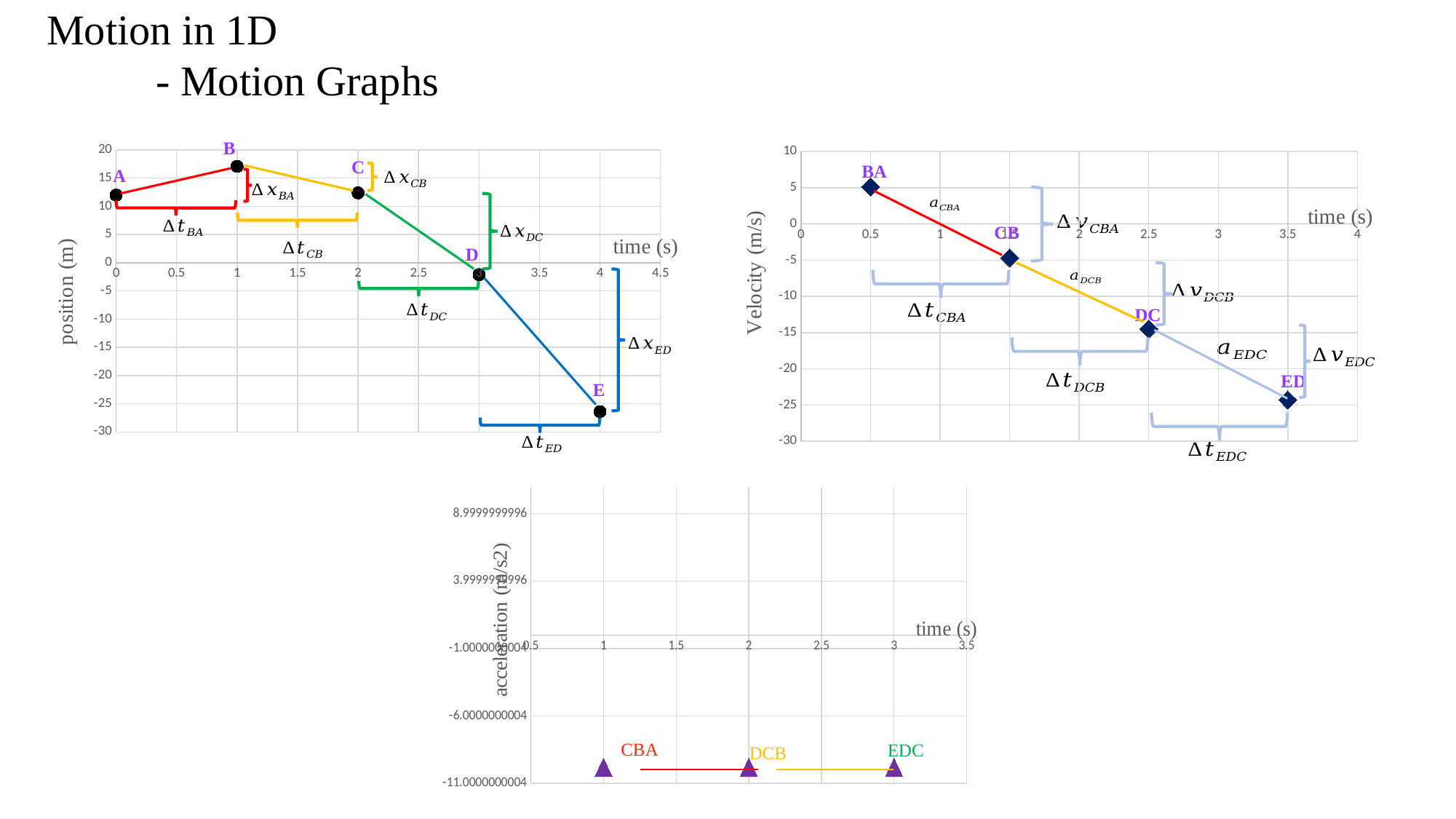
In the position vs time chart, how many labelled data points are plotted? 5 In the position vs time chart, at what time does point D occur? 3 In the position vs time chart, which has the larger position, point B or point C? B What kind of chart is the position vs time chart at the top left? line chart In the position vs time chart, which point has the lowest position? E In the velocity vs time chart, is the velocity at point ED greater or less than -20? less In the velocity vs time chart, do the velocity values rise or fall as time increases? fall In the position vs time chart, which point has the highest position? B In the velocity vs time chart, how many data points are plotted? 4 What is the y-axis title of the bottom chart? acceleration (m/s2) In the position vs time chart, is the position of point E greater or less than -20? less